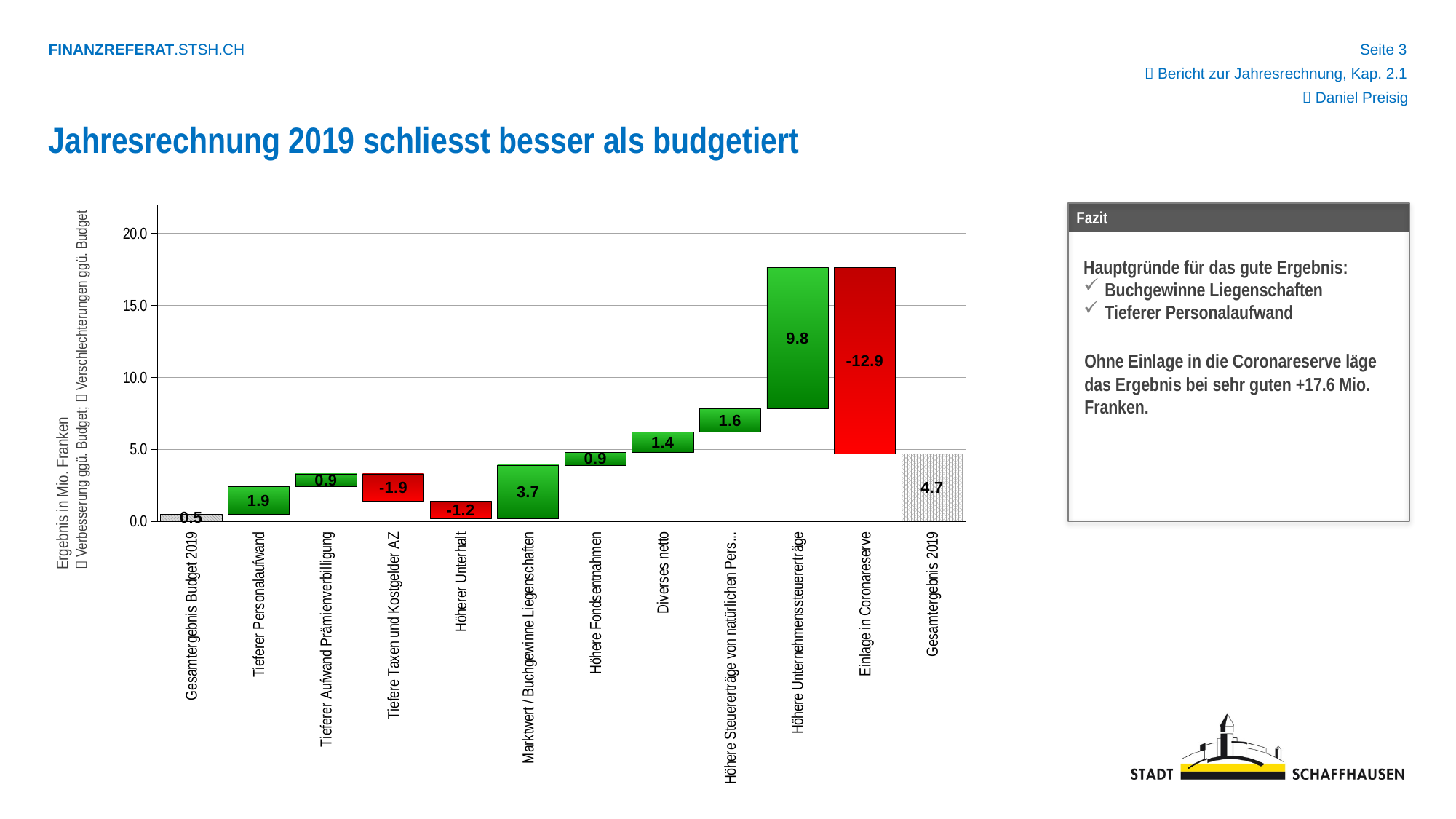
How many categories are shown on the x axis of the chart? 12 What is the value shown for Marktwert / Buchgewinne Liegenschaften? 3.7 What kind of chart is shown on the slide? Waterfall bar chart What is the value shown for Einlage in Coronareserve? -12.9 What is the value shown for Höherer Unterhalt? -1.2 What is the difference between the values for Höhere Unternehmenssteuererträge and Marktwert / Buchgewinne Liegenschaften? 6.1 What is the value shown for Gesamtergebnis 2019? 4.7 Which category has the lowest (most negative) value? Einlage in Coronareserve Which is larger, the value for Diverses netto or the value for Höhere Fondsentnahmen? Diverses netto What is the value shown for Tieferer Personalaufwand? 1.9 What unit does the y axis label say the values are in? Mio. Franken Which category has the largest positive value? Höhere Unternehmenssteuererträge